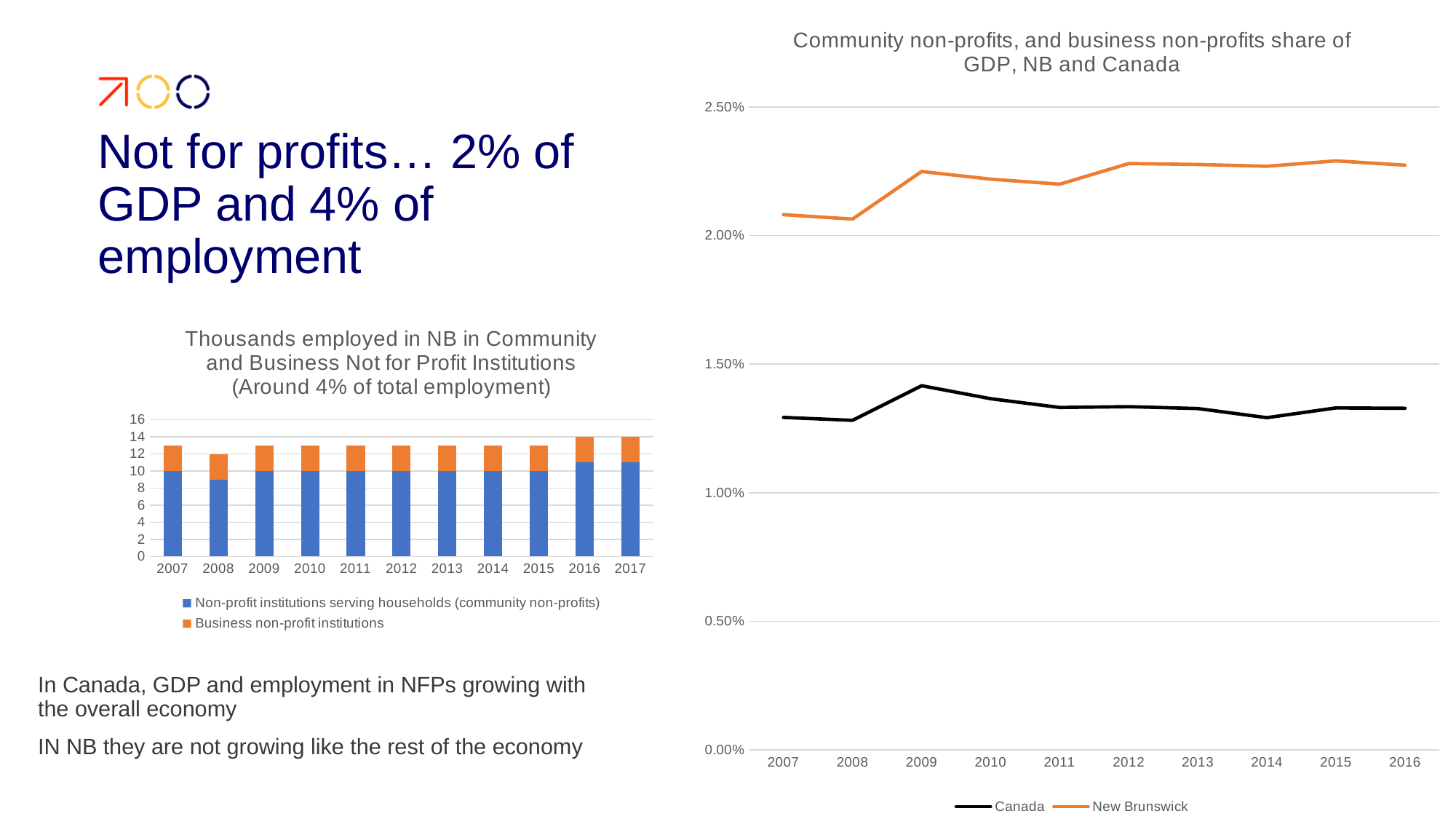
In the bar chart on the left, what is the total height of the stacked bar for 2016? 14 In the line chart on the right, is the value for New Brunswick in 2007 greater or less than 2.00%? greater In the bar chart on the left, what is the value for Non-profit institutions serving households in 2007? 10 What kind of chart is the chart titled 'Thousands employed in NB in Community and Business Not for Profit Institutions'? Stacked bar chart In the bar chart on the left, what is the total height of the stacked bar for 2008? 12 In the line chart on the right, in which year does the Canada series reach its highest value? 2009 In the line chart on the right, how many series does the legend list? 2 In the bar chart on the left, how many years are shown on the x axis? 11 What kind of chart is the chart titled 'Community non-profits, and business non-profits share of GDP, NB and Canada'? Line chart In the line chart on the right, is the value for Canada in 2009 greater or less than 1.50%? less In the line chart on the right, which series has the higher value in 2016, Canada or New Brunswick? New Brunswick In the bar chart on the left, is the total for 2007 greater or less than 12? greater